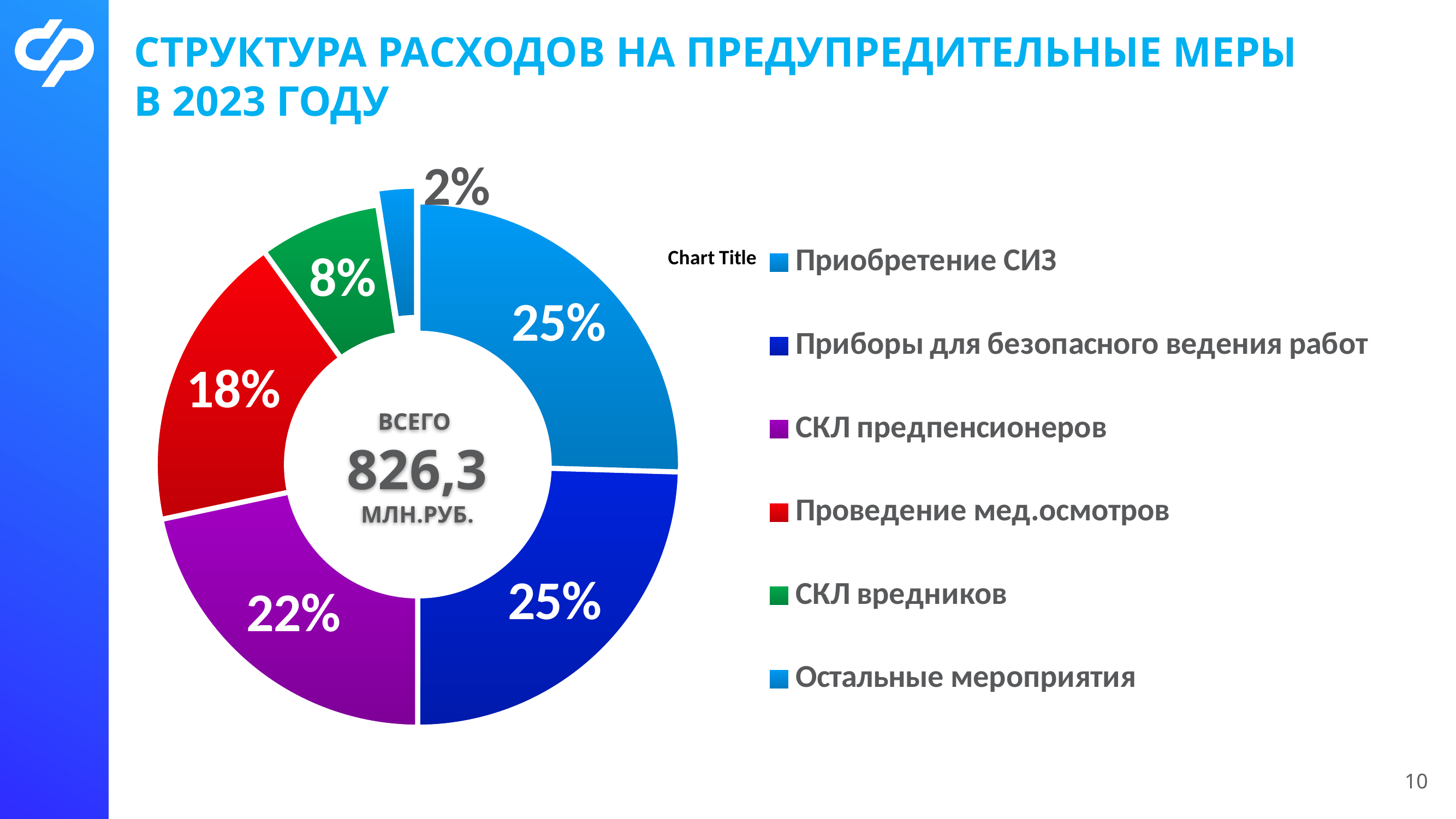
What share of expenses is shown for Остальные мероприятия? 2% What share of expenses is shown for СКЛ предпенсионеров? 22% What share of expenses is shown for Приобретение СИЗ? 25% What colour is the slice for Проведение мед.осмотров? red What kind of chart is shown on the slide? doughnut (pie) chart What share of expenses is shown for СКЛ вредников? 8% What total amount is shown in the centre of the chart? 826,3 млн.руб. Which is larger: the share for СКЛ предпенсионеров or the share for Проведение мед.осмотров? СКЛ предпенсионеров How many categories does the chart show? 6 Which category has the smallest share of expenses? Остальные мероприятия What is the difference in percentage points between the share for Приборы для безопасного ведения работ and the share for СКЛ вредников? 17 percentage points What share of expenses is shown for Проведение мед.осмотров? 18%